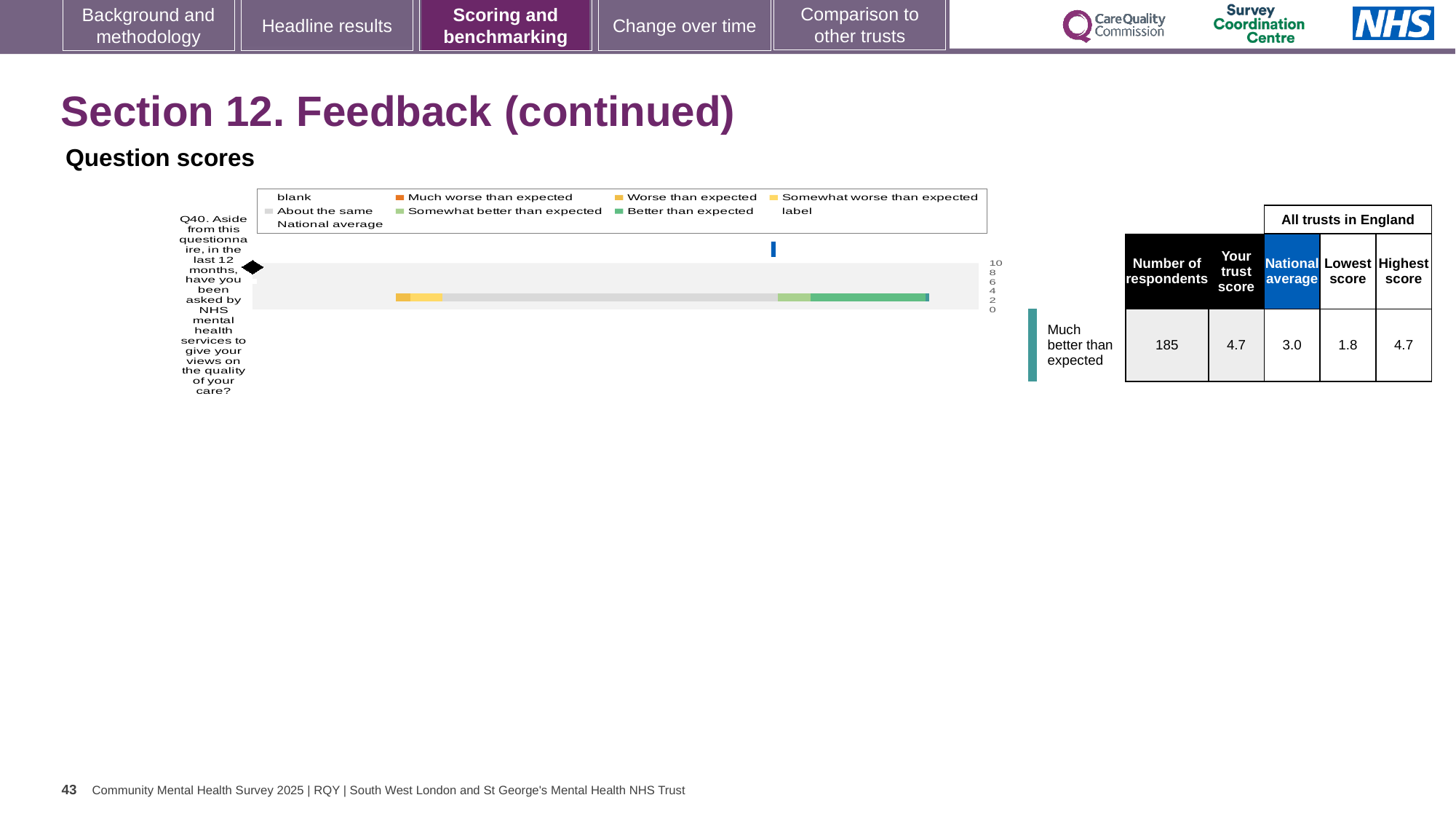
In the table beside the chart, what is the national average for Q40? 3.0 In the table beside the chart, what is the difference between your trust score and the national average for Q40? 1.7 What colour does the legend use for 'Much worse than expected'? orange What kind of chart is shown under 'Question scores'? bar chart In the table beside the chart, what is the number of respondents for Q40? 185 Which question number is plotted on the chart? Q40 In the table beside the chart, what is the lowest score across all trusts in England for Q40? 1.8 How many entries does the chart legend list? 9 How many question categories are plotted on the chart? 1 What is the highest tick value shown on the chart's axis? 10 In the table beside the chart, what is 'Your trust score' for Q40? 4.7 In the table beside the chart, which is larger for Q40: your trust score or the national average? Your trust score